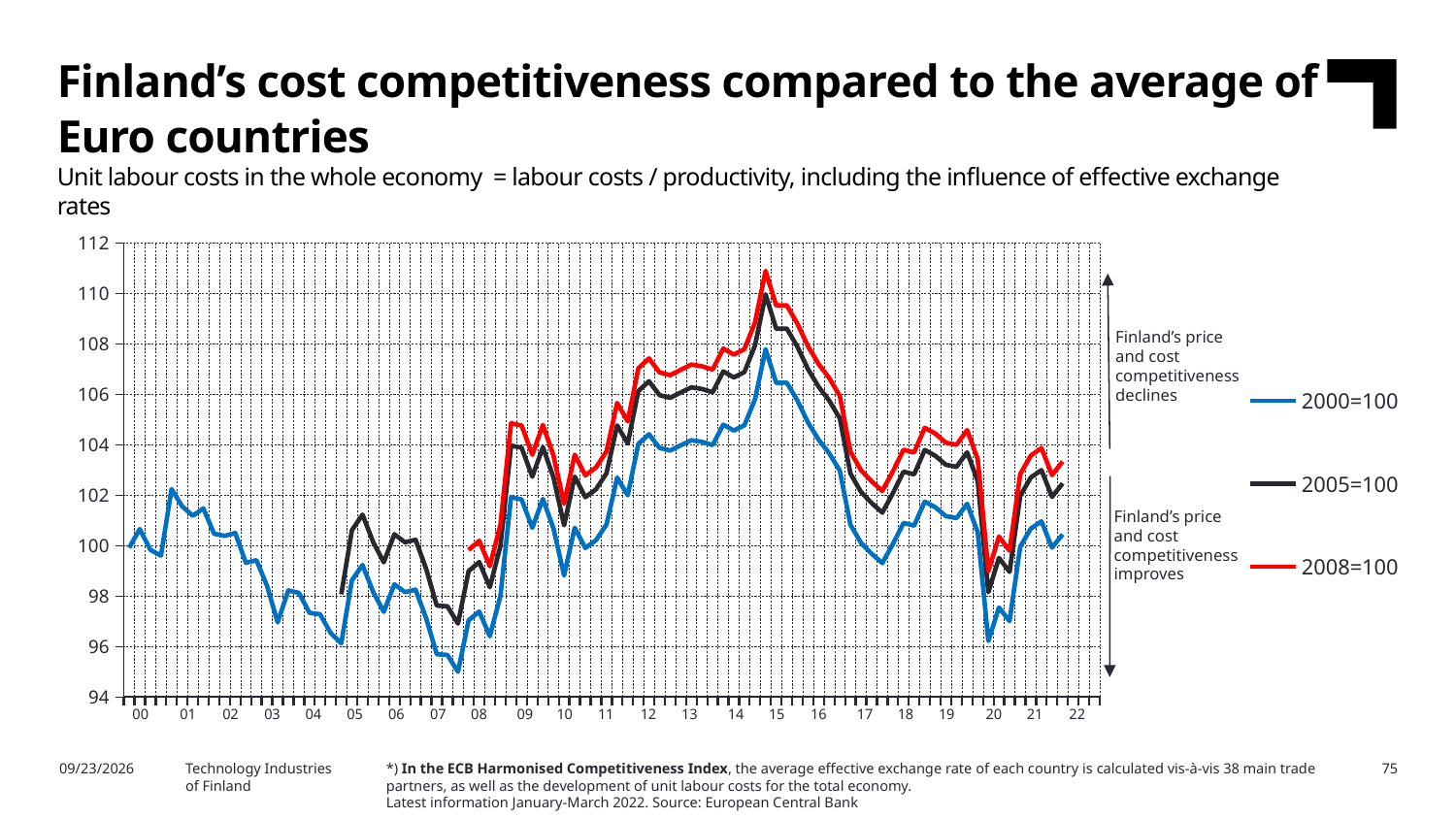
Is the peak value of the 2008=100 series around 2015 greater or less than 108? greater Is the lowest value of the 2000=100 series around 2007 greater or less than 98? less Which series has the lowest values across the period from 2008 onwards? 2000=100 How many year labels are shown on the x axis? 23 Which series is drawn in blue? 2000=100 Is the peak value of the 2000=100 series around 2015 greater or less than 106? greater How many series does the legend list? 3 Do the series rise or fall between 2015 and 2017? fall At the 2015 peak, which series has the higher value, 2008=100 or 2000=100? 2008=100 Which series is drawn in red? 2008=100 What kind of chart is shown on the slide? line chart